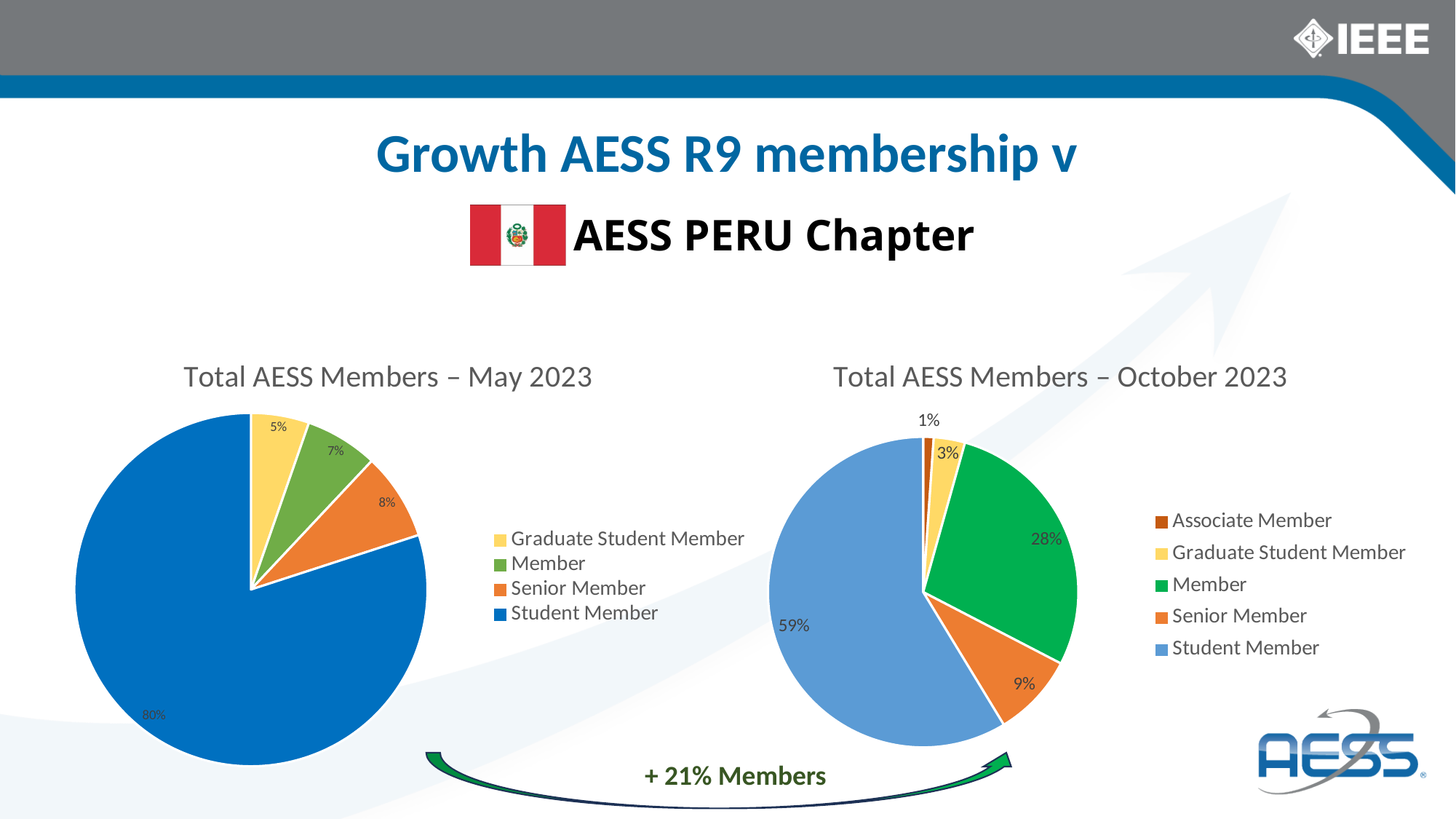
How many categories does the legend of the 'Total AESS Members – May 2023' chart list? 4 In the 'Total AESS Members – October 2023' chart, what is the difference in percentage points between Student Member and Member? 31 In the 'Total AESS Members – May 2023' chart, what share of members are Student Members? 80% In the 'Total AESS Members – May 2023' chart, what percentage is shown for Senior Member? 8% What type of chart is 'Total AESS Members – May 2023'? Pie chart In the 'Total AESS Members – October 2023' chart, what share of members are Associate Members? 1% In the 'Total AESS Members – October 2023' chart, what percentage is shown for Member? 28% In the 'Total AESS Members – May 2023' chart, which is larger: the Member share or the Senior Member share? Senior Member How many categories does the legend of the 'Total AESS Members – October 2023' chart list? 5 In the 'Total AESS Members – May 2023' chart, which category has the smallest share? Graduate Student Member What growth in members is stated between the May 2023 and October 2023 charts? + 21% Members In the 'Total AESS Members – October 2023' chart, which category has the largest share? Student Member